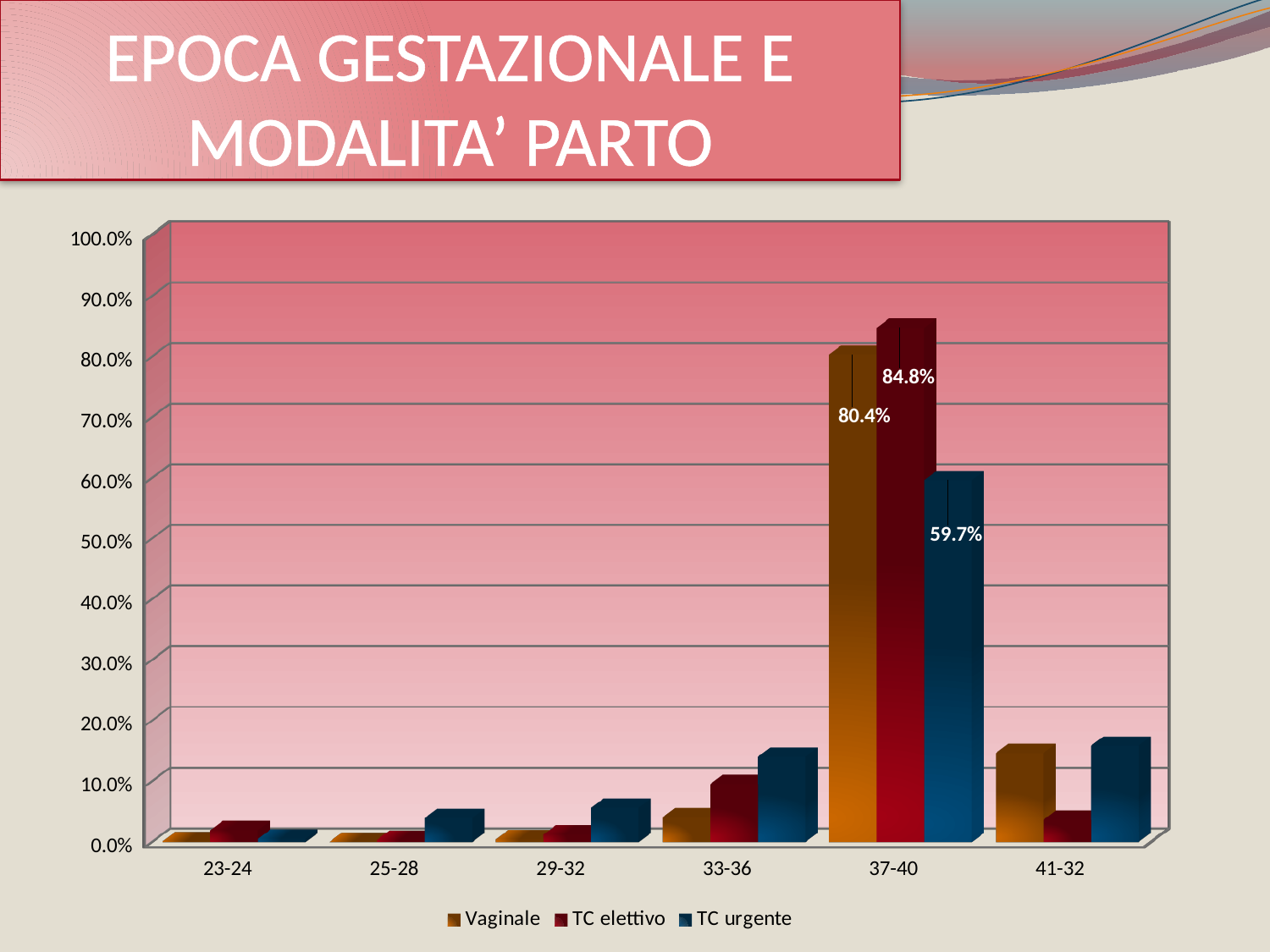
Which category has the highest value for TC elettivo? 37-40 What is the value for TC urgente in the 37-40 category? 59.7% In the 37-40 category, which series has the lowest value? TC urgente What is the value for TC elettivo in the 37-40 category? 84.8% Is the value for TC urgente in the 33-36 category greater or less than 20.0%? less Is the value for TC elettivo in the 41-32 category greater or less than 10.0%? less What kind of chart is shown on the slide? Bar chart What is the difference between TC elettivo and Vaginale in the 37-40 category? 4.4 percentage points In the 37-40 category, which is larger: Vaginale or TC elettivo? TC elettivo How many gestational age categories are shown on the x axis? 6 How many series does the legend list? 3 What is the value for Vaginale in the 37-40 category? 80.4%